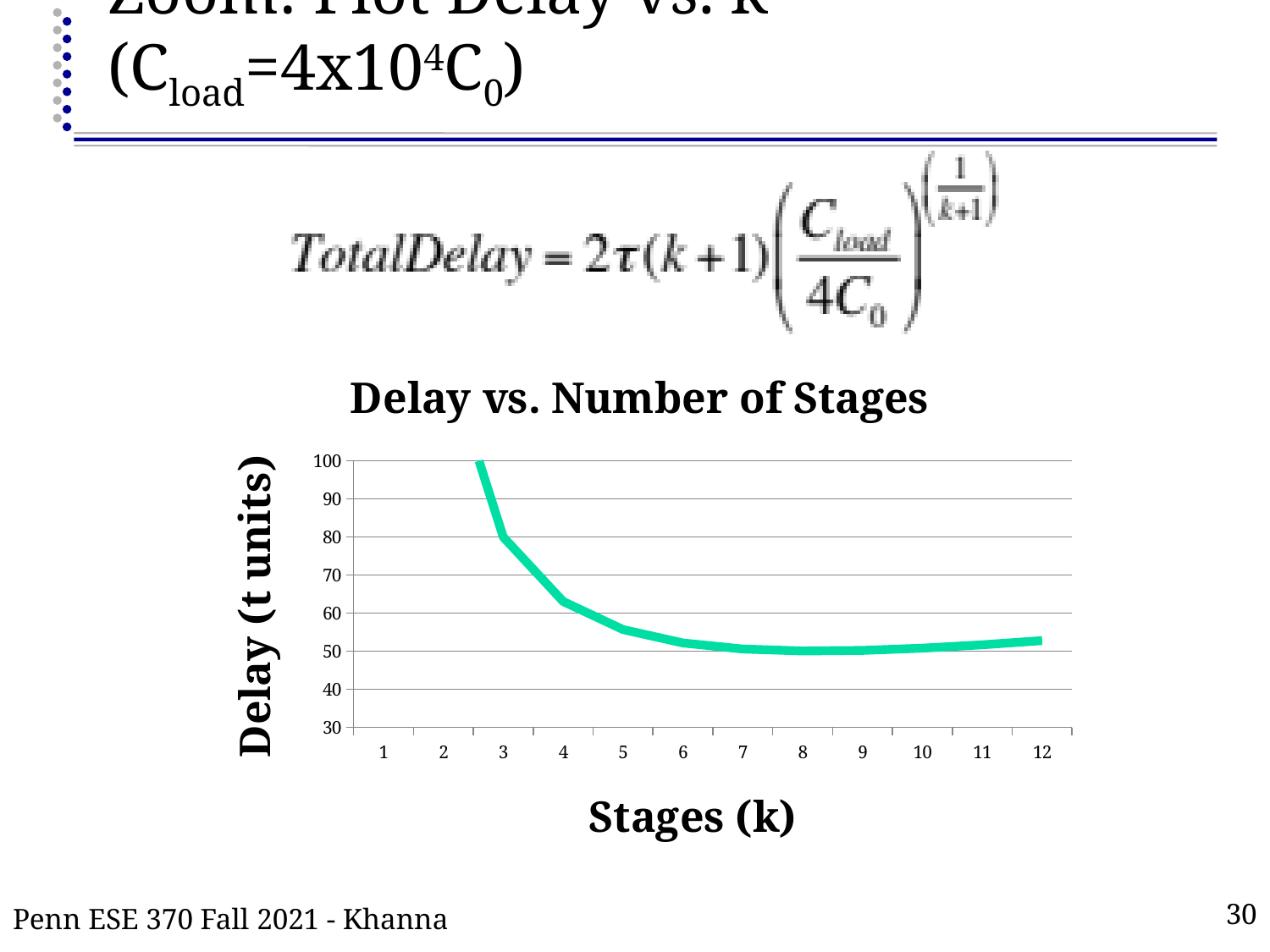
Is the delay at k = 5 greater or less than 60? less Is the delay at k = 3 greater or less than 70? greater Is the delay at k = 4 greater or less than 70? less How many stage values (k) are marked along the x axis? 12 What is the label of the y axis of the chart? Delay (t units) What is the title of the chart? Delay vs. Number of Stages Which has the larger delay, k = 3 or k = 12? k = 3 Do the delay values rise or fall as k increases from 3 to 8? fall What kind of chart is shown on the slide? line chart Which has the larger delay, k = 4 or k = 8? k = 4